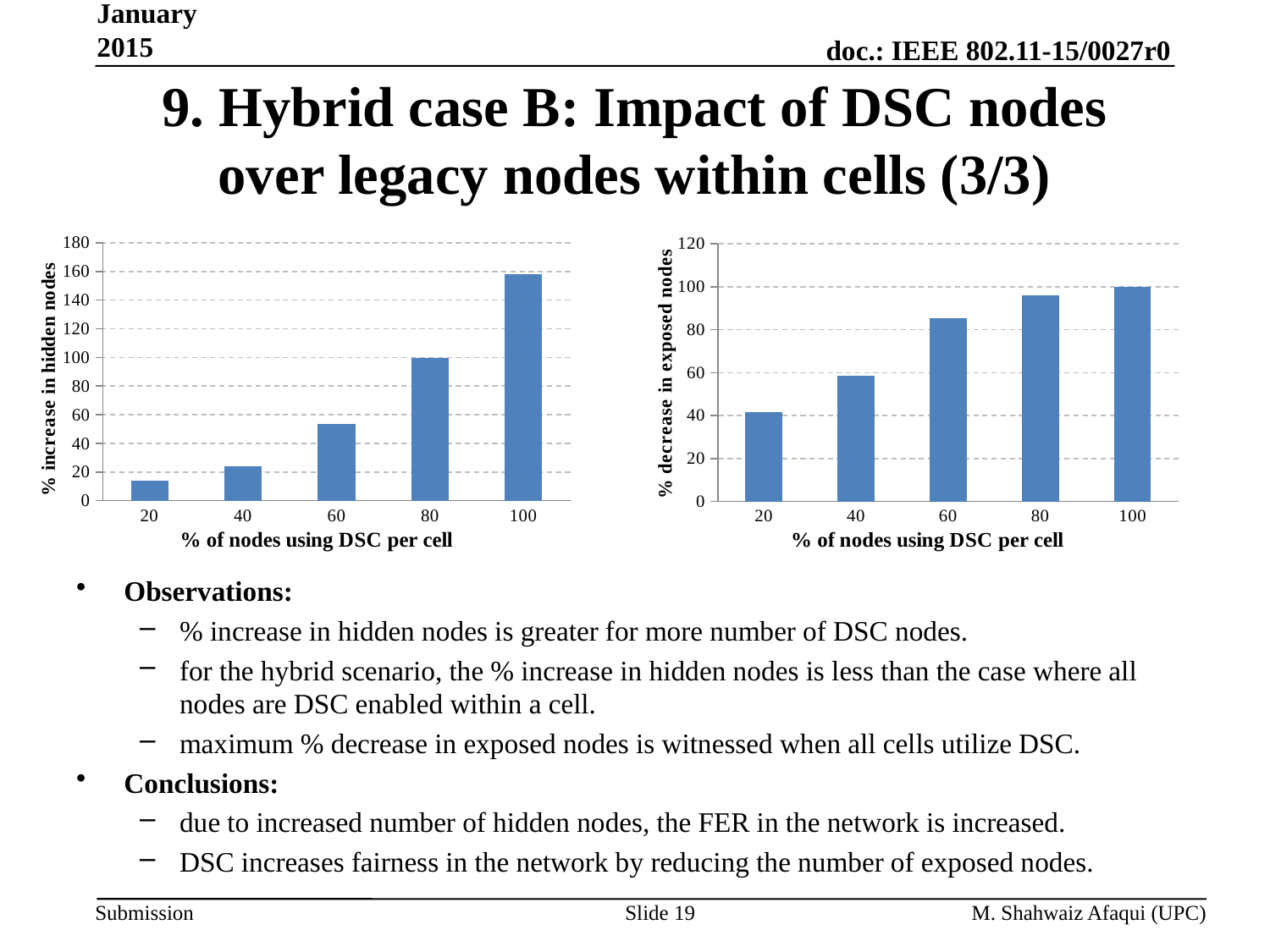
In the right chart (% decrease in exposed nodes), which % of nodes using DSC per cell has the lowest value? 20 In the left chart (% increase in hidden nodes), is the value for 100 greater or less than 140? greater In the right chart (% decrease in exposed nodes), is the value for 60 greater or less than 80? greater In the left chart (% increase in hidden nodes), is the value for 60 greater or less than 60? less What kind of chart is the left chart (% increase in hidden nodes)? bar chart In the left chart (% increase in hidden nodes), which is larger, the value for 40 or the value for 60? 60 In the right chart (% decrease in exposed nodes), do the values rise or fall as the % of nodes using DSC per cell increases? rise How many categories are shown on the x axis of the right chart (% decrease in exposed nodes)? 5 In the left chart (% increase in hidden nodes), which % of nodes using DSC per cell has the highest value? 100 In the left chart (% increase in hidden nodes), which % of nodes using DSC per cell has the lowest value? 20 What is the x-axis title of the left chart? % of nodes using DSC per cell